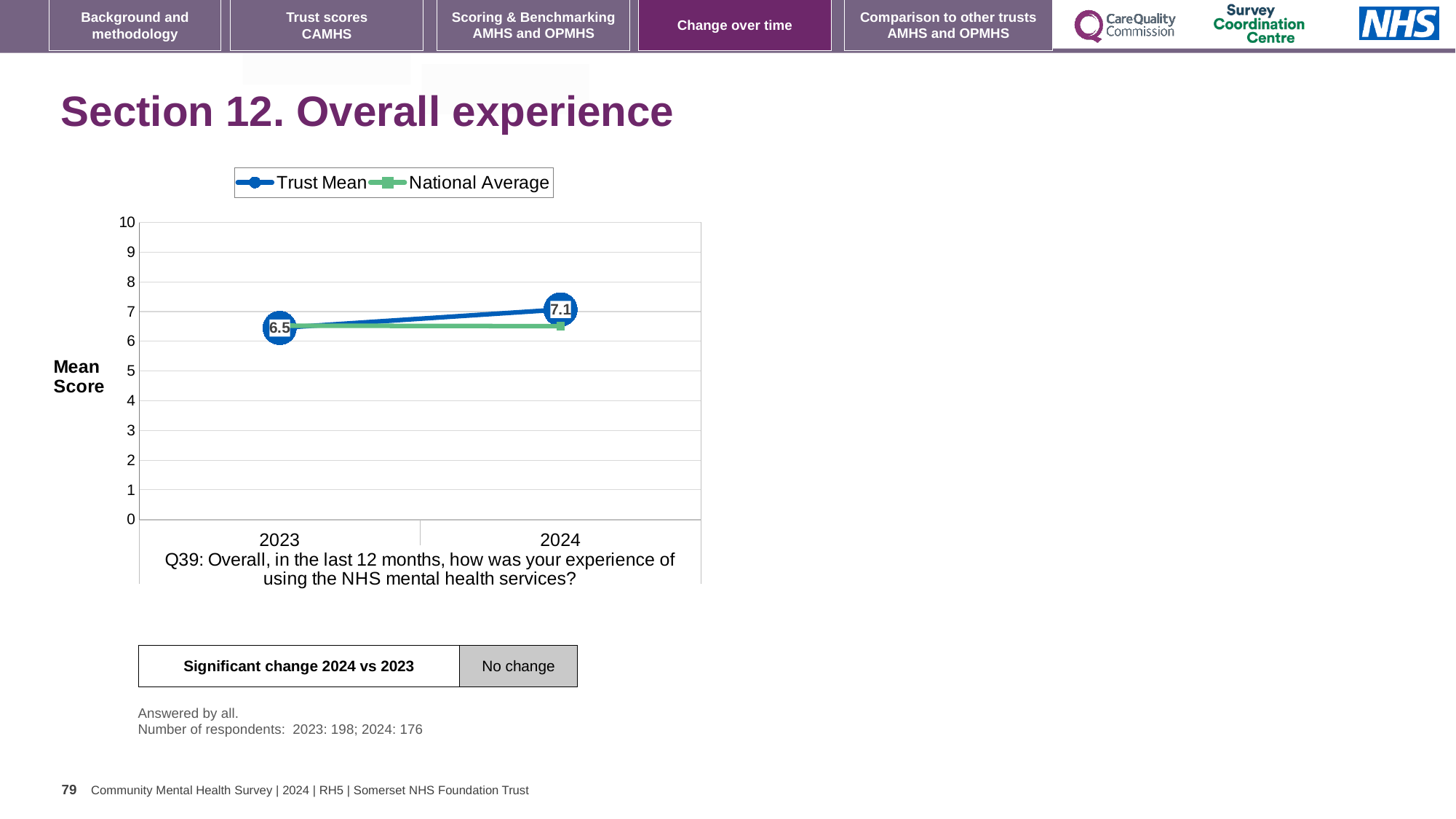
In 2024, which is larger: the Trust Mean or the National Average? Trust Mean How many years are plotted on the x axis? 2 What is the Trust Mean value for 2023? 6.5 How many series does the legend list? 2 Does the Trust Mean rise or fall from 2023 to 2024? rise By how much did the Trust Mean change from 2023 to 2024? 0.6 Is the National Average value for 2024 greater or less than 7? less What is the Trust Mean value for 2024? 7.1 What kind of chart is shown on the slide? line chart In which year is the Trust Mean highest? 2024 In which year is the Trust Mean lowest? 2023 What is the label on the y axis of the chart? Mean Score